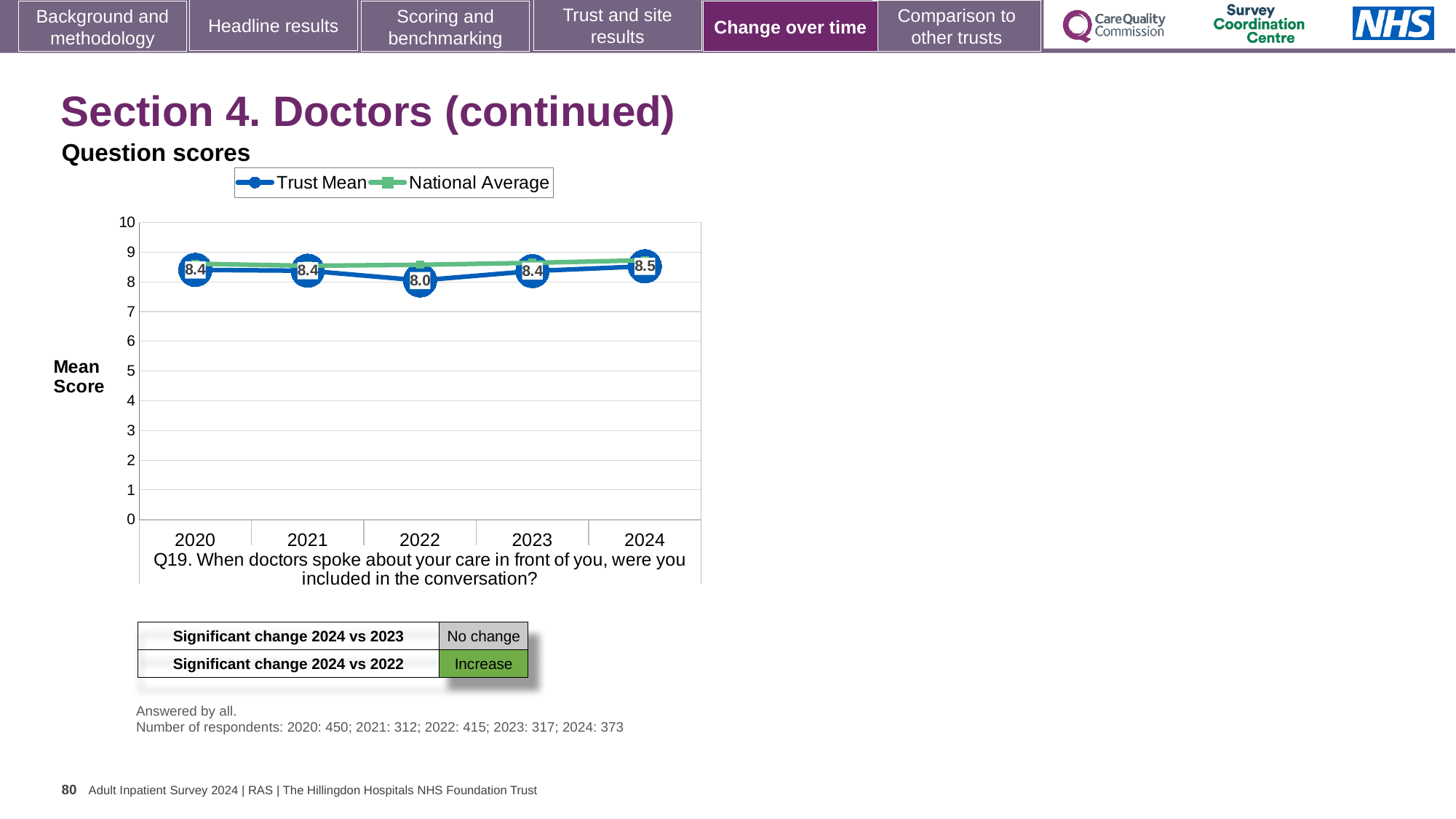
What is the Trust Mean score for 2022? 8.0 What is the Trust Mean score for 2024? 8.5 How many series does the legend list? 2 How many years are plotted on the x axis? 5 Which series is shown in green in the legend? National Average Is the National Average value for 2024 greater or less than 8? greater What kind of chart is shown on the slide? line chart What is the Trust Mean score for 2020? 8.4 In which year is the Trust Mean score lowest? 2022 What is the difference between the Trust Mean score in 2024 and in 2022? 0.5 Is the Trust Mean score for 2023 larger or smaller than the Trust Mean score for 2022? larger In which year is the Trust Mean score highest? 2024